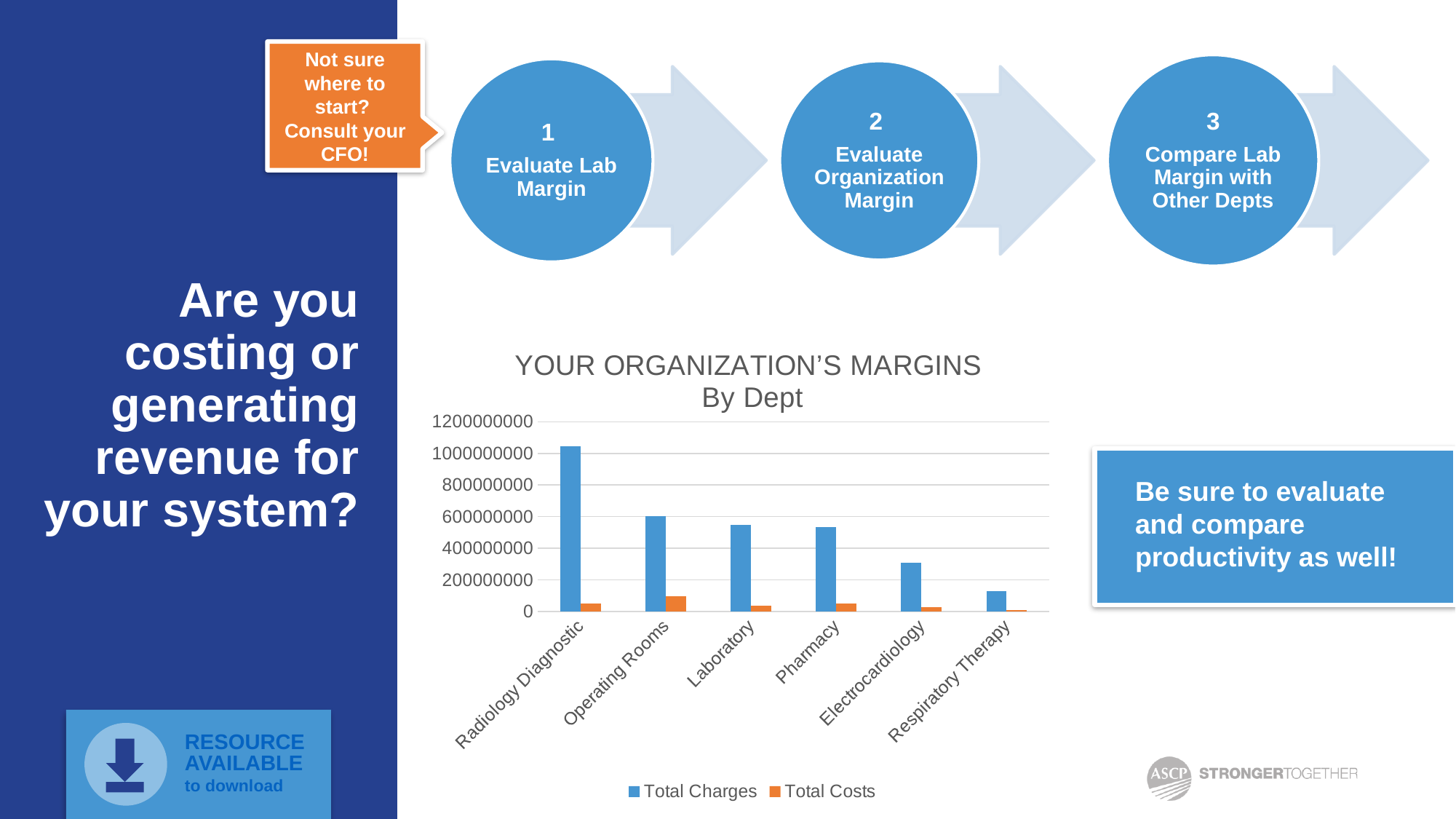
How many series does the chart's legend list? 2 Is the Total Costs value for Operating Rooms greater or less than 200000000? less Which department has the lowest Total Charges? Respiratory Therapy What kind of chart is shown under the title "YOUR ORGANIZATION'S MARGINS By Dept"? Bar chart Which is larger, the Total Charges for Operating Rooms or for Electrocardiology? Operating Rooms Is the Total Charges value for Respiratory Therapy greater or less than 200000000? less Which department has the highest Total Charges? Radiology Diagnostic Which department has the highest Total Costs? Operating Rooms How many departments are shown on the x axis of the chart? 6 Is the Total Charges value for Electrocardiology greater or less than 400000000? less Which series is shown in orange in the chart's legend? Total Costs